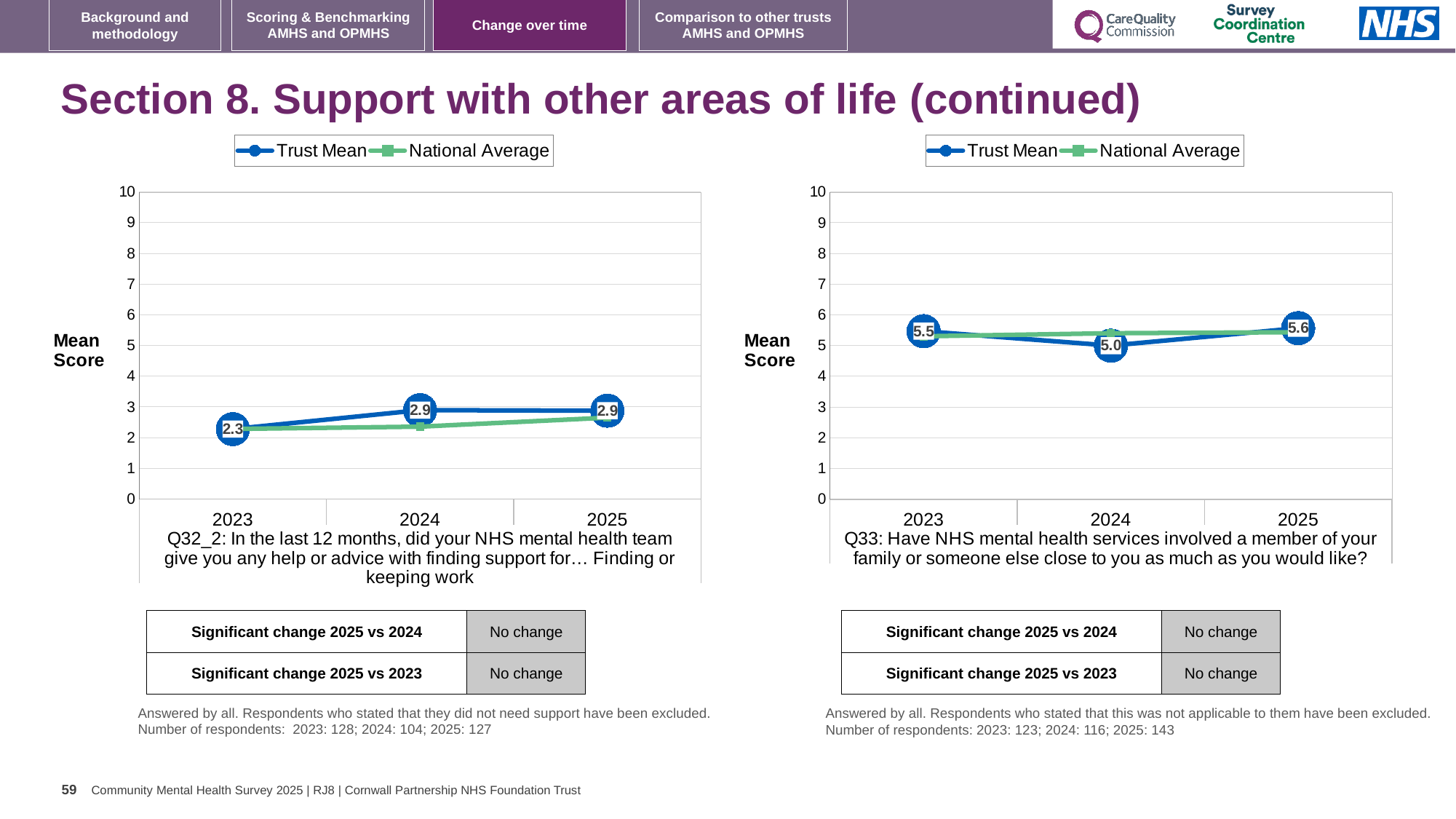
On the left chart (Q32_2), what is the Trust Mean for 2025? 2.9 On the left chart (Q32_2), what is the Trust Mean for 2023? 2.3 On the right chart (Q33), which year has the lowest Trust Mean? 2024 On the right chart (Q33), what is the Trust Mean for 2025? 5.6 How many series does the legend of the left chart (Q32_2) list? 2 What kind of chart is the right chart (Q33)? Line chart On the right chart (Q33), what is the difference between the Trust Mean for 2025 and for 2024? 0.6 On the right chart (Q33), is the Trust Mean higher in 2023 or in 2024? 2023 On the left chart (Q32_2), which year has the lowest Trust Mean? 2023 On the right chart (Q33), is the National Average for 2024 greater or less than 5? greater On the left chart (Q32_2), what is the difference between the Trust Mean for 2025 and for 2023? 0.6 On the right chart (Q33), what is the Trust Mean for 2024? 5.0